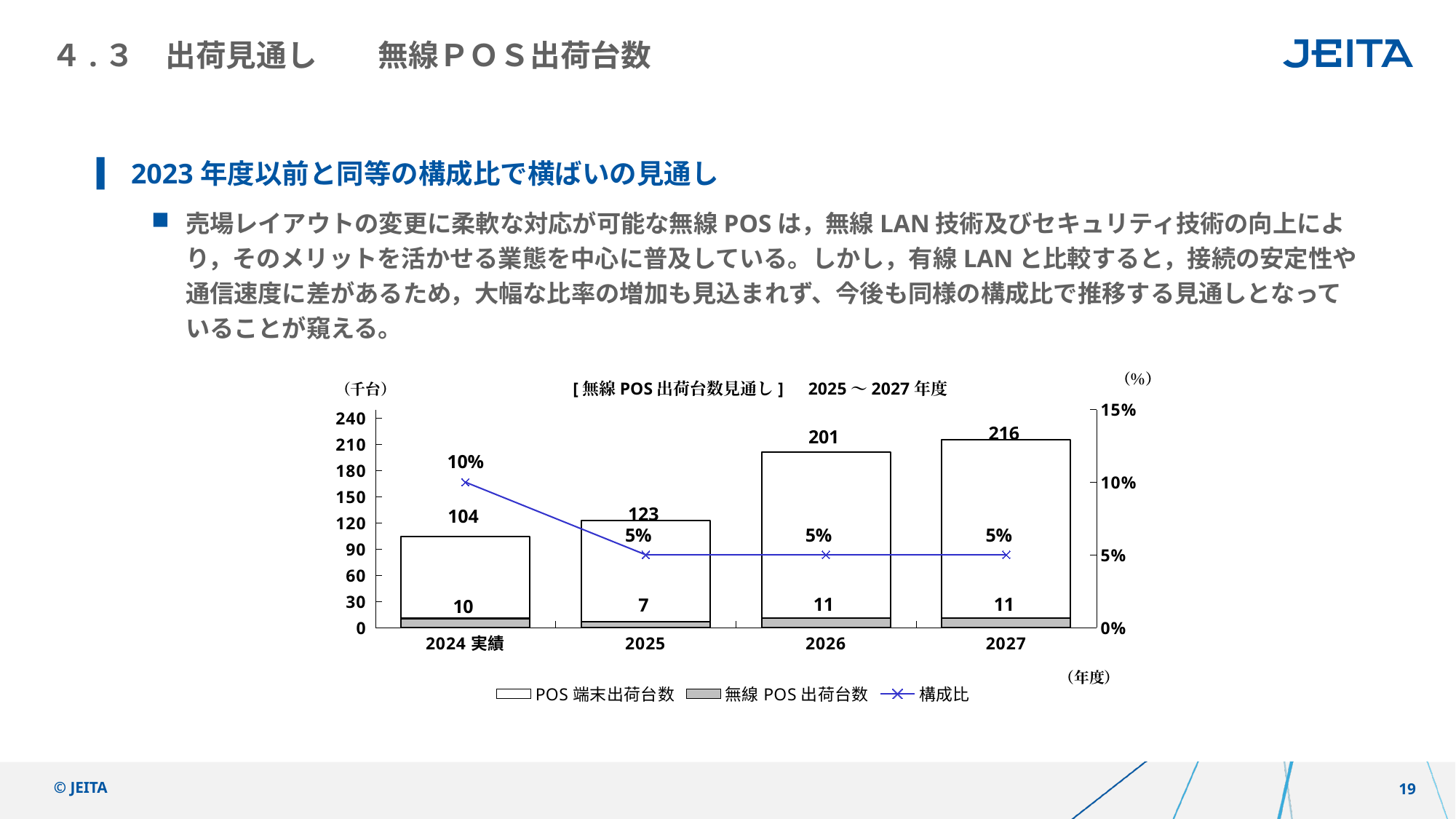
What is the 構成比 value for 2024 実績? 10% Which year has the highest POS 端末出荷台数 value? 2027 How many years are shown on the x axis? 4 Does the POS 端末出荷台数 value rise or fall from 2024 実績 to 2027? rise What is the difference between the POS 端末出荷台数 values for 2027 and 2024 実績? 112 What is the POS 端末出荷台数 value for 2026? 201 How many series does the legend list? 3 Is the POS 端末出荷台数 value for 2025 greater or less than 150? less What kind of chart is this? Combined bar and line chart Which year has the lowest 無線 POS 出荷台数 value? 2025 Which is larger, the 無線 POS 出荷台数 value for 2024 実績 or for 2026? 2026 What is the 無線 POS 出荷台数 value for 2025? 7